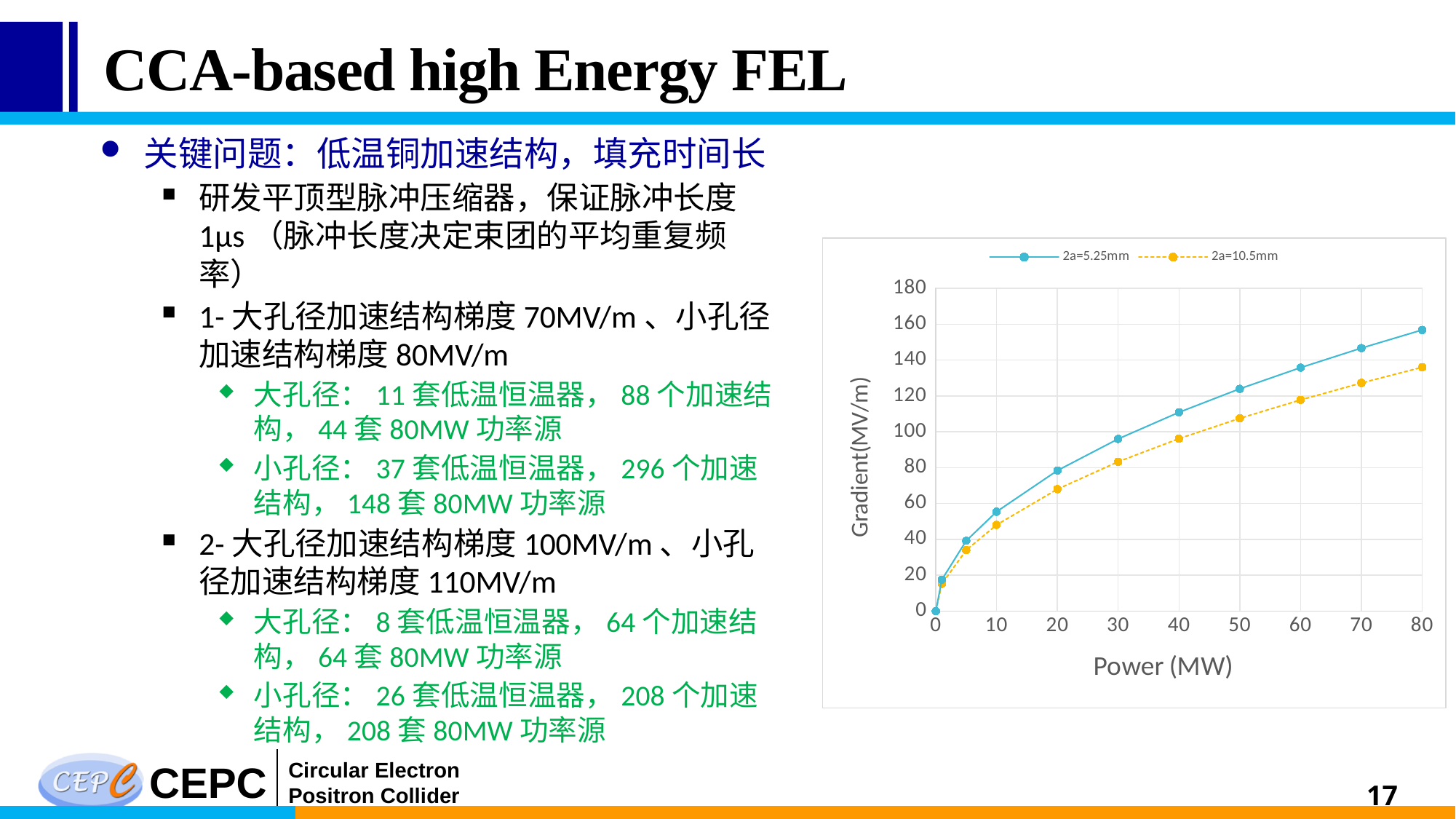
Is the gradient for 2a=5.25mm at 60 MW greater or less than 120? greater Does the gradient rise or fall as power increases along the x axis? rise What are the two series named in the chart's legend? 2a=5.25mm and 2a=10.5mm How many series does the chart's legend list? 2 Is the gradient for 2a=5.25mm at 40 MW greater or less than 100? greater Is the gradient for 2a=5.25mm at 80 MW greater or less than 140? greater At 80 MW, which series has the higher gradient, 2a=5.25mm or 2a=10.5mm? 2a=5.25mm What kind of chart is shown on the slide? line chart What is the label of the chart's x axis? Power (MW)